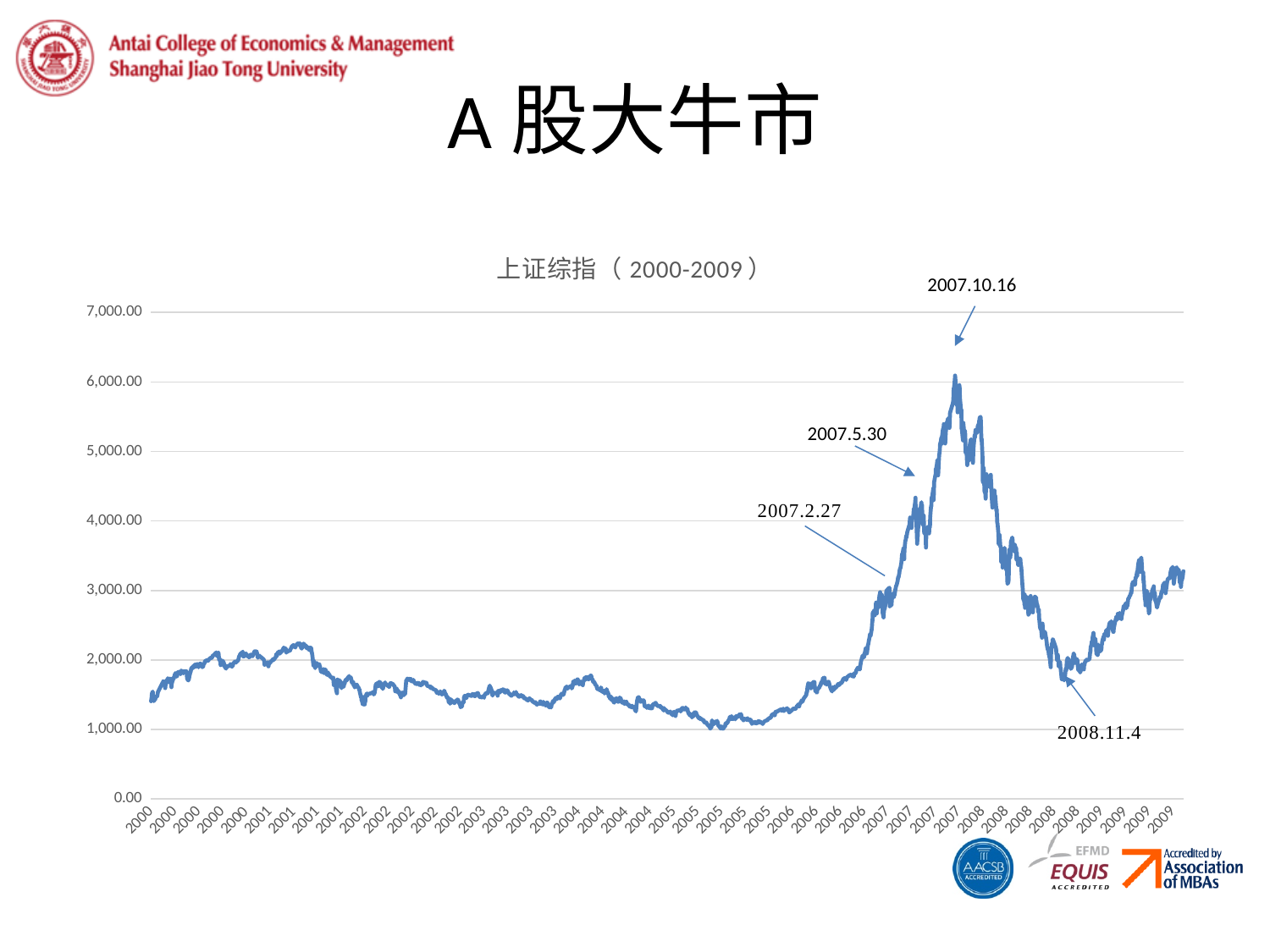
How many date annotations with arrows are shown on the chart? 4 Is the value of the index at the 2007.10.16 peak greater or less than 5,000? greater Is the value of the index at the start of 2000 greater or less than 1,000? greater Is the value of the index at 2008.11.4 greater or less than 2,000? less What is the title of the chart? 上证综指（2000-2009） What kind of chart is shown on the slide? line chart Does the index rise or fall between 2007.10.16 and 2008.11.4? fall Which annotated date marks the lowest point of the index after the 2007 peak? 2008.11.4 What is the highest value shown on the vertical axis? 7,000.00 Which date annotation marks the peak of the index on the chart? 2007.10.16 Does the index rise or fall between mid-2005 and 2007.10.16? rise